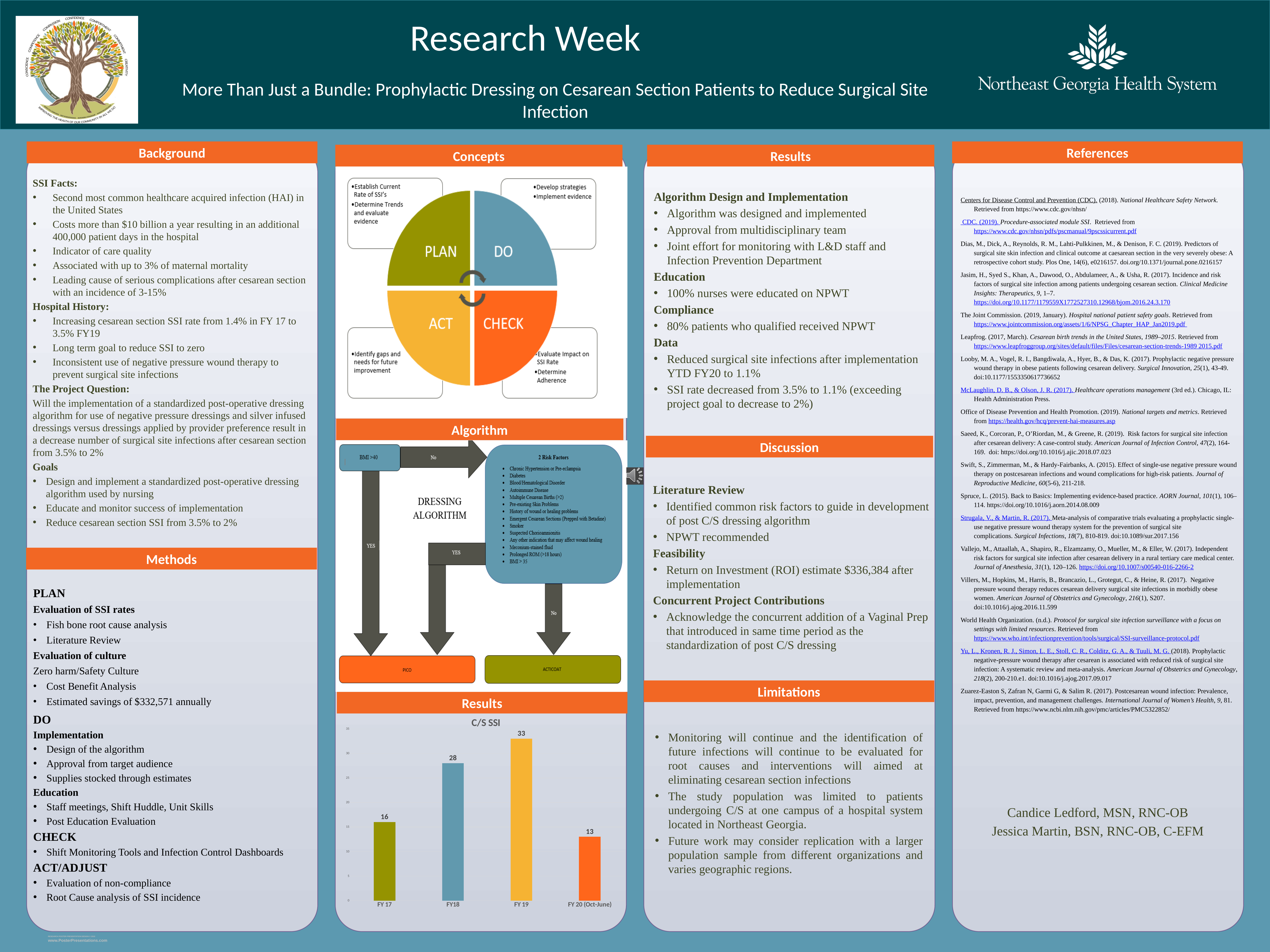
In the C/S SSI chart, what is the difference between the FY 17 value and the FY 20 (Oct-June) value? 3 What kind of chart is the C/S SSI chart? bar chart In the C/S SSI chart, what is the value for FY18? 28 How many categories are shown in the C/S SSI chart? 4 In the C/S SSI chart, what is the value for FY 17? 16 In the C/S SSI chart, what is the value for FY 19? 33 In the C/S SSI chart, is the value for FY 19 greater or less than 30? greater In the C/S SSI chart, which category has the highest value? FY 19 In the C/S SSI chart, which category has the lowest value? FY 20 (Oct-June) In the C/S SSI chart, which is larger, the value for FY 17 or the value for FY18? FY18 In the C/S SSI chart, what is the difference between the FY 19 value and the FY18 value? 5 In the C/S SSI chart, what is the value for FY 20 (Oct-June)? 13